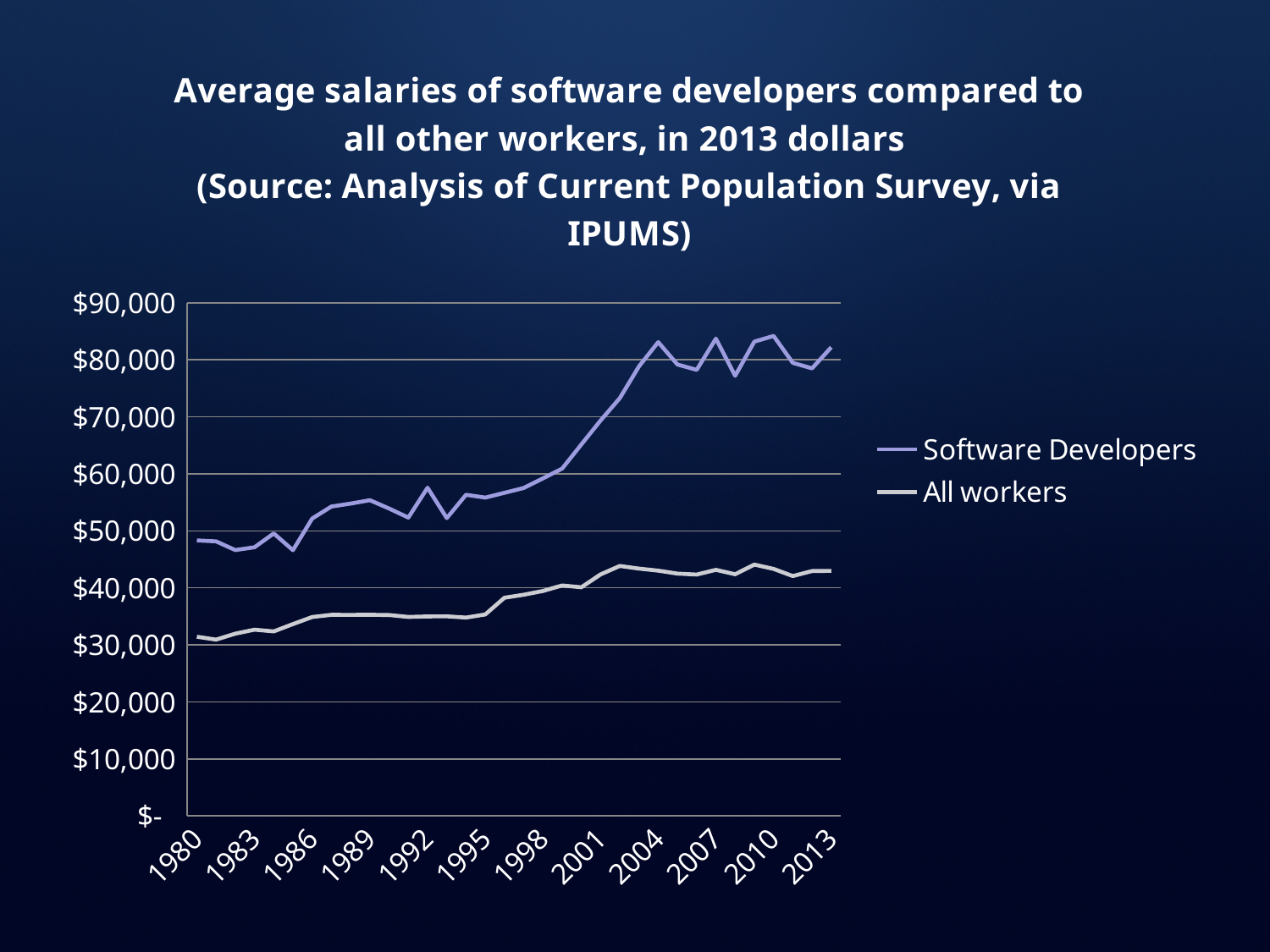
Do the values for Software Developers generally rise or fall from 1980 to 2013? rise What kind of chart is shown on the slide? Line chart How many series does the legend list? 2 Is the value for Software Developers in 1980 greater or less than $40,000? greater Which two series are listed in the legend? Software Developers and All workers How many year labels are shown on the x axis? 12 Is the value for All workers in 1989 greater or less than $40,000? less Is the value for Software Developers in 2013 greater or less than $70,000? greater In 2013, which series has the larger value, Software Developers or All workers? Software Developers